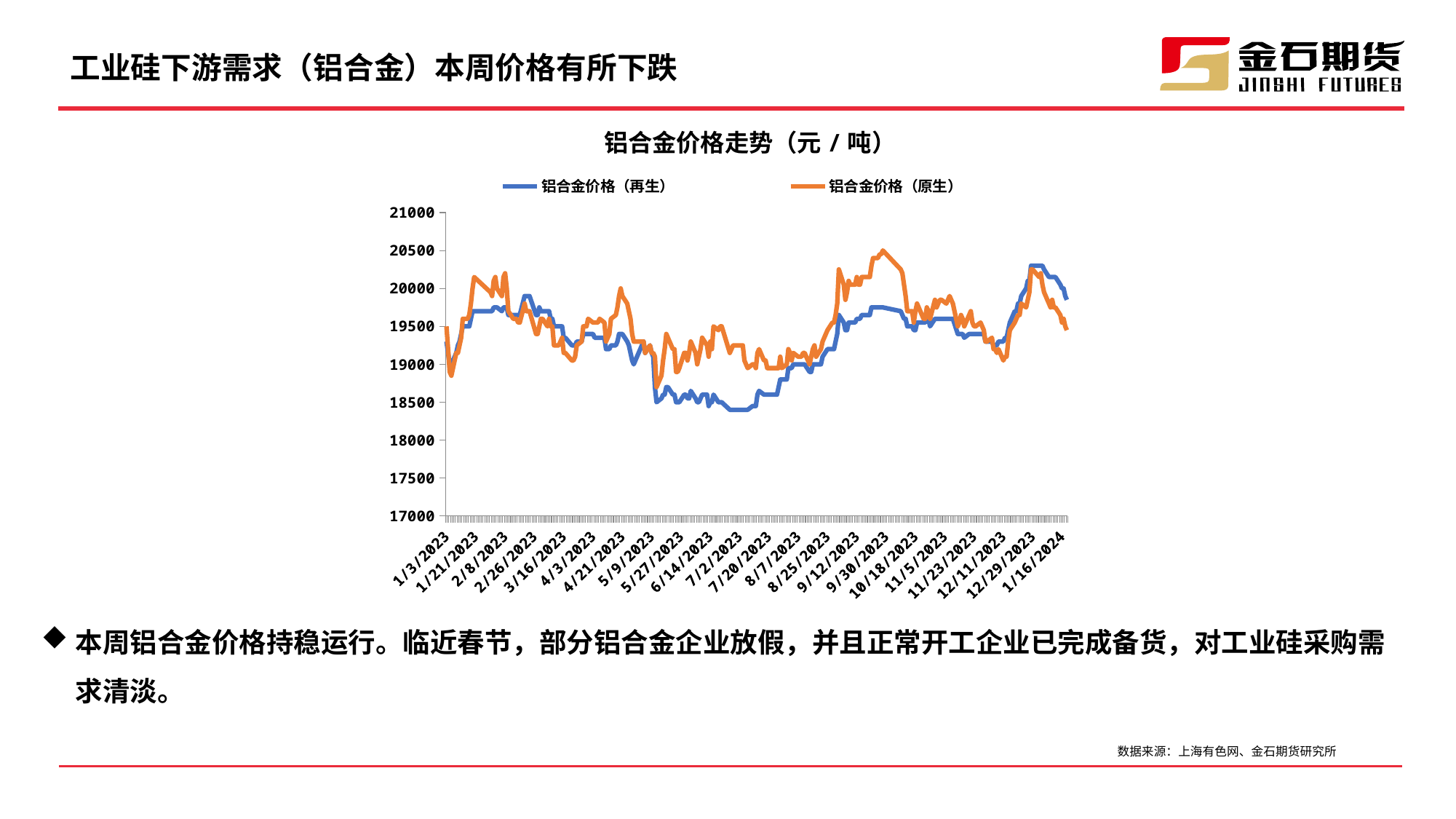
Is the value of 铝合金价格（再生） around 12/29/2023 greater or less than 20000? greater Which series reaches the lowest value anywhere on the chart? 铝合金价格（再生） Around 9/30/2023, which series has the higher value, 铝合金价格（再生） or 铝合金价格（原生）? 铝合金价格（原生） Which colour is used for the 铝合金价格（再生） series? blue Around 7/2/2023, which series has the higher value, 铝合金价格（再生） or 铝合金价格（原生）? 铝合金价格（原生） Does the 铝合金价格（原生） series rise or fall between 9/30/2023 and 11/5/2023? fall Is the peak value of 铝合金价格（原生） around 9/30/2023 greater or less than 20000? greater What kind of chart is shown on the slide? line chart Is the value of 铝合金价格（原生） around 7/2/2023 greater or less than 18500? greater What is the title of the chart? 铝合金价格走势（元 / 吨） How many series does the legend list? 2